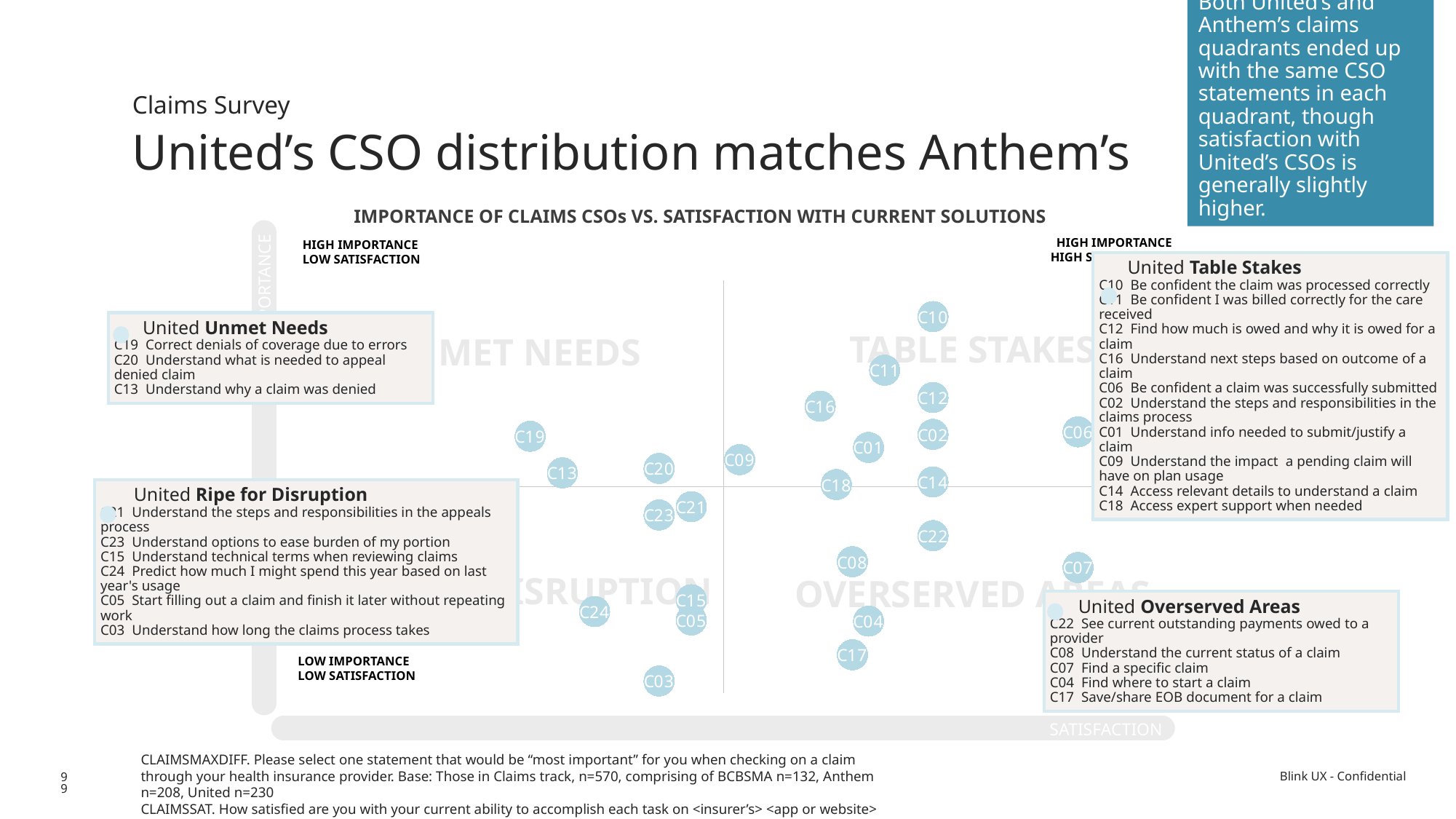
What is the title of the chart? IMPORTANCE OF CLAIMS CSOs VS. SATISFACTION WITH CURRENT SOLUTIONS Which CSO point is plotted highest on the importance axis? C10 How many CSO statements are listed in the United Unmet Needs box? 3 Which CSO point is plotted lowest on the importance axis? C03 In which quadrant of the chart does point C03 fall? Ripe for Disruption How many CSO points are plotted on the chart? 24 What does the horizontal axis of the chart represent? Satisfaction In which quadrant of the chart does point C10 fall? Table Stakes Which is plotted further right on the satisfaction axis, C14 or C13? C14 Which is plotted higher on the importance axis, C10 or C17? C10 What kind of chart is shown on the slide? Scatter plot Which CSO point is plotted furthest left on the satisfaction axis? C19